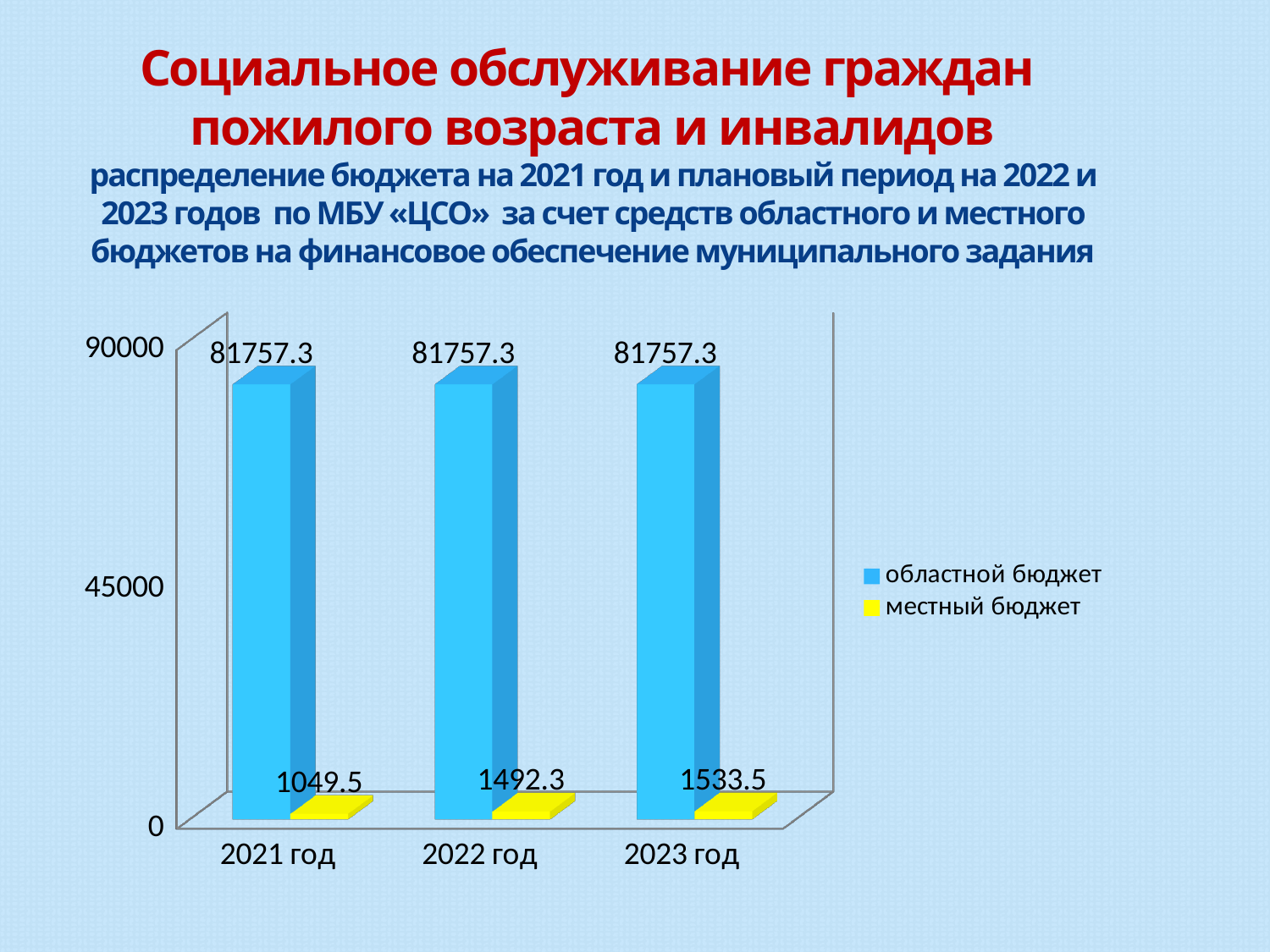
What is the value for местный бюджет in 2021 год? 1049.5 How many series does the legend list? 2 How many years are shown on the x axis? 3 What is the value for областной бюджет in 2021 год? 81757.3 In which year is местный бюджет the lowest? 2021 год What is the value for местный бюджет in 2023 год? 1533.5 Which is larger in 2023 год: областной бюджет or местный бюджет? областной бюджет Is the value for областной бюджет in 2022 год greater or less than 45000? greater Does местный бюджет rise or fall from 2021 год to 2023 год? rise In which year is местный бюджет the highest? 2023 год What is the value for местный бюджет in 2022 год? 1492.3 What is the difference between местный бюджет in 2022 год and 2021 год? 442.8